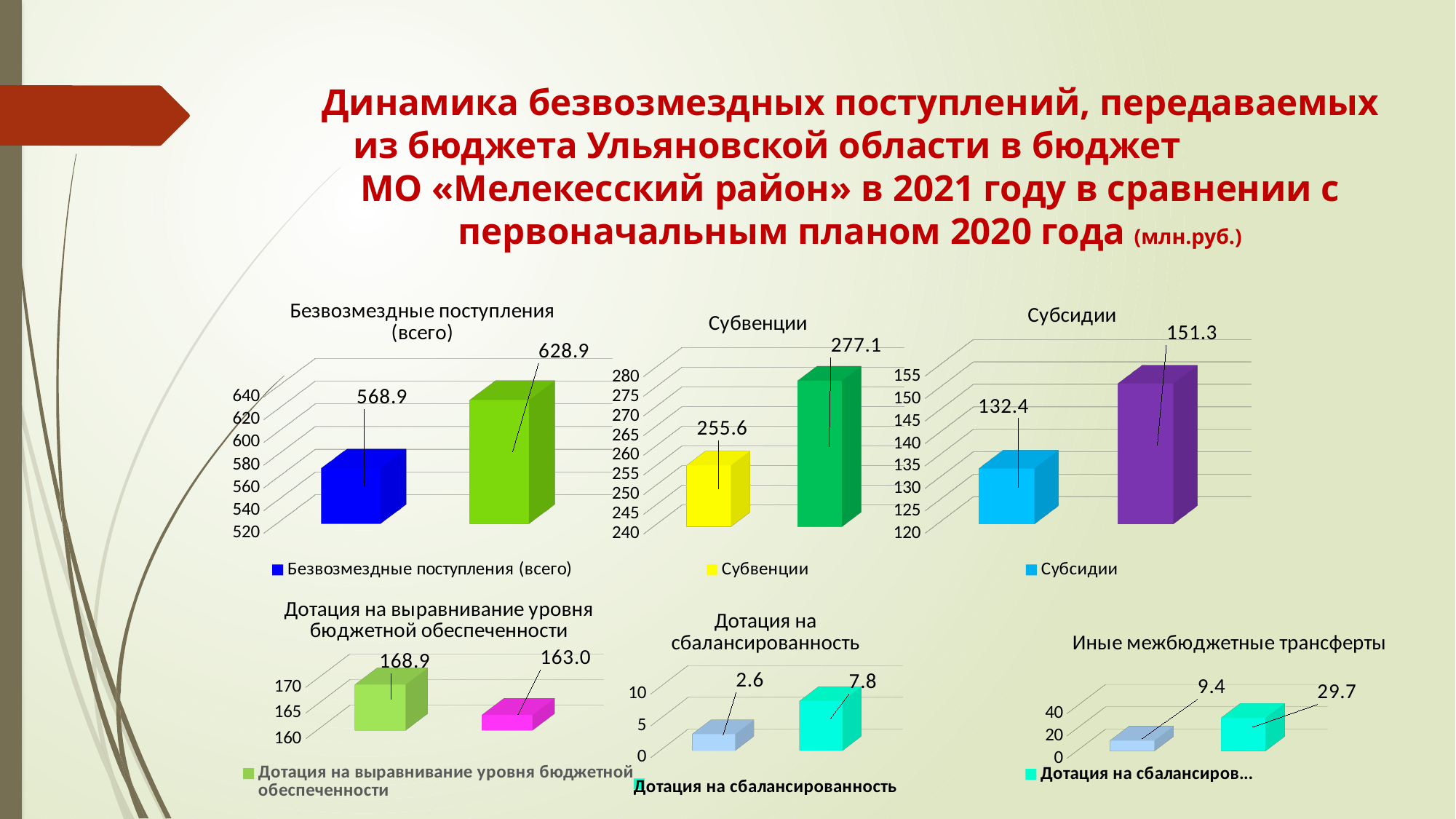
In the chart titled «Субсидии», which bar is larger, the left (light blue) bar or the right (purple) bar? the right (purple) bar In the chart titled «Дотация на выравнивание уровня бюджетной обеспеченности», what value is printed on the magenta bar? 163.0 In the chart titled «Безвозмездные поступления (всего)», what value is printed on the right (green) bar? 628.9 In the chart titled «Иные межбюджетные трансферты», what value is printed on the right (cyan) bar? 29.7 What kind of chart is the one titled «Безвозмездные поступления (всего)»? bar chart In the chart titled «Иные межбюджетные трансферты», which bar is the lowest? the left bar (9.4) In the chart titled «Безвозмездные поступления (всего)», what value is printed on the left (blue) bar? 568.9 How many bars are plotted in the chart titled «Субвенции»? 2 In the chart titled «Дотация на сбалансированность», what is the difference between the right bar (7.8) and the left bar (2.6)? 5.2 In the chart titled «Дотация на выравнивание уровня бюджетной обеспеченности», do the values rise or fall from the left bar to the right bar? fall In the chart titled «Субсидии», what value is printed on the purple bar? 151.3 In the chart titled «Субвенции», what is the difference between the right bar (277.1) and the left bar (255.6)? 21.5